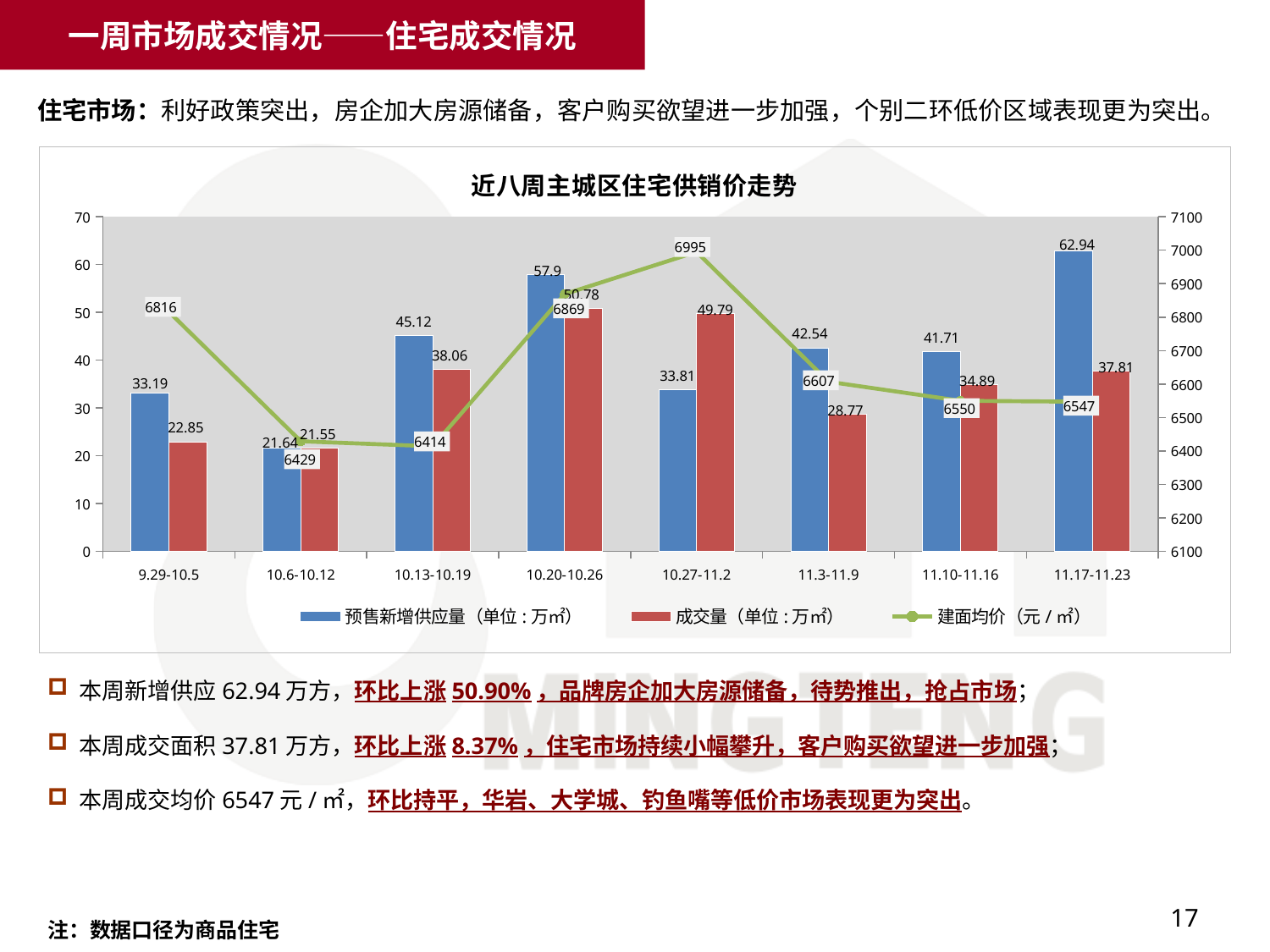
What kind of chart is this? Combined bar and line chart Which period has the lowest 成交量? 10.6-10.12 What is the 建面均价 value for 10.27-11.2? 6995 Which period has the lowest 建面均价? 10.13-10.19 What is the 成交量 value for 10.20-10.26? 50.78 What is the 预售新增供应量 value for 11.17-11.23? 62.94 Which is larger for 10.27-11.2, the 预售新增供应量 or the 成交量? 成交量 What is the title of the chart? 近八周主城区住宅供销价走势 What is the difference between the 预售新增供应量 and 成交量 for 11.17-11.23? 25.13 How many periods are shown on the x axis? 8 How many series does the legend list? 3 Which period has the highest 预售新增供应量? 11.17-11.23